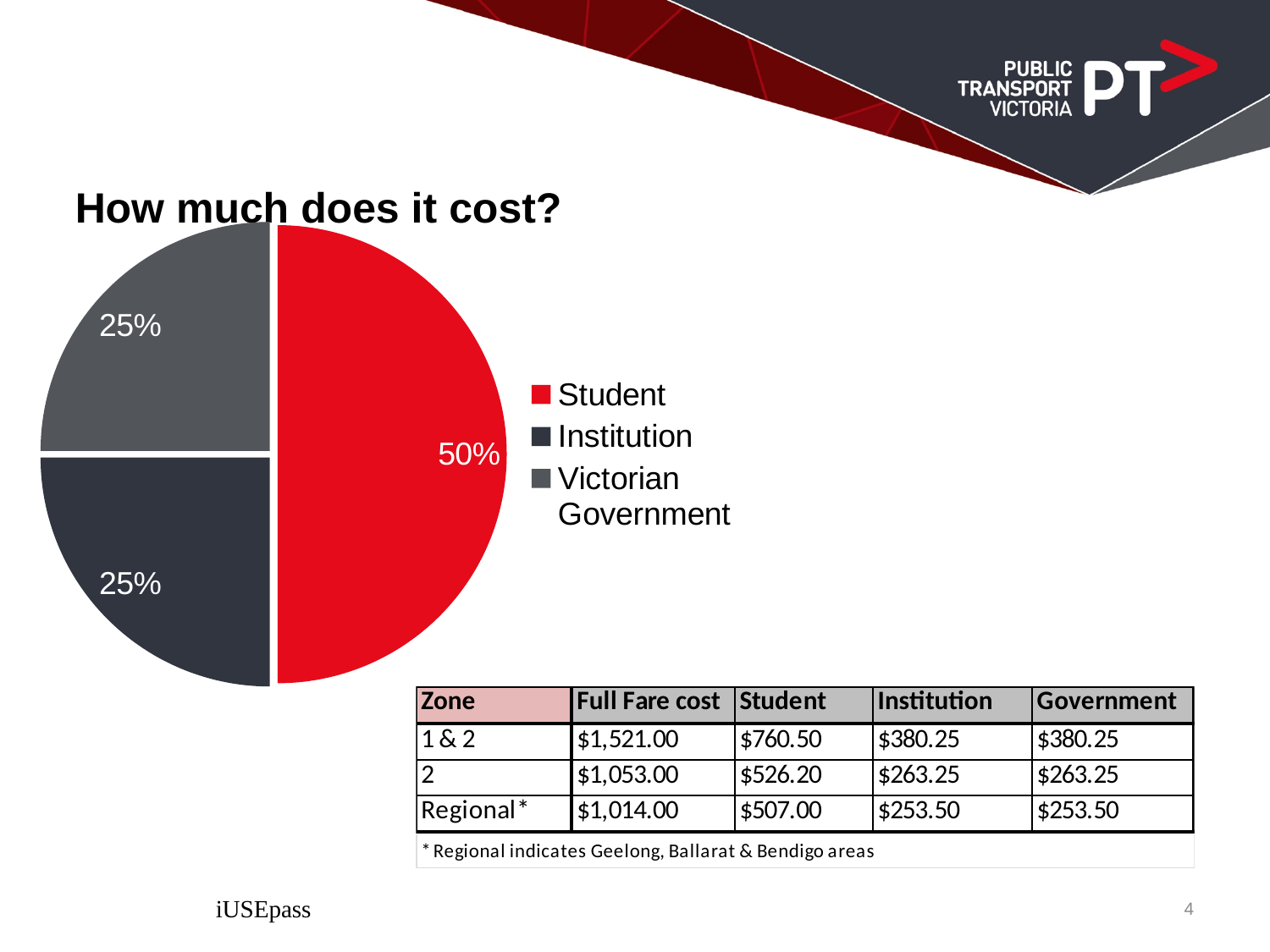
Which category has the largest slice of the pie? Student How many entries does the legend of the pie chart list? 3 What are the three legend entries of the pie chart? Student, Institution, Victorian Government What share of the pie does the Institution slice represent? 25% What share of the pie does the Victorian Government slice represent? 25% Which is larger in the pie chart, the Student share or the Institution share? Student How many slices does the pie chart have? 3 What is the combined share of the Institution and Victorian Government slices? 50% What is the difference between the Student share and the Institution share in the pie chart? 25% What kind of chart is shown on the slide? pie chart What share of the pie does the Student slice represent? 50% What colour is the Student slice in the pie chart? red